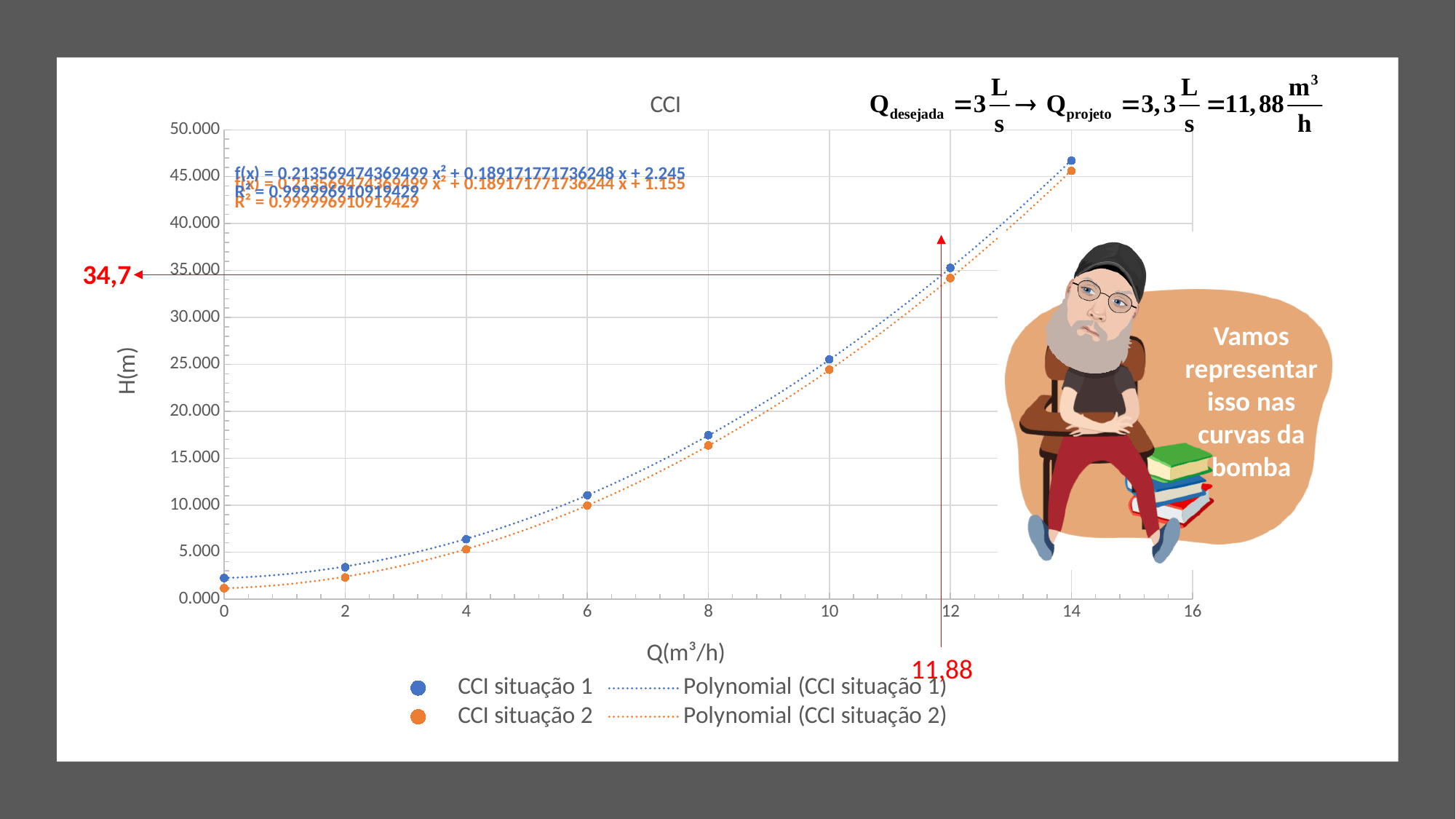
What kind of chart is shown on the slide? scatter chart How many entries does the chart legend list? 4 Do the H(m) values for CCI situação 2 rise or fall as Q(m³/h) increases? rise What is the label of the x axis? Q(m³/h) Is the value for CCI situação 1 at Q = 8 greater or less than 15.000? greater At which Q(m³/h) value does CCI situação 1 reach its highest H(m)? 14 Is the value for CCI situação 2 at Q = 10 greater or less than 25.000? less Is the value for CCI situação 1 at Q = 14 greater or less than 45.000? greater How many data points are plotted for the CCI situação 1 series? 8 What is the title of the chart? CCI What Q value is marked in red below the x axis by the vertical line? 11,88 At Q = 12, which series has the higher H(m) value, CCI situação 1 or CCI situação 2? CCI situação 1